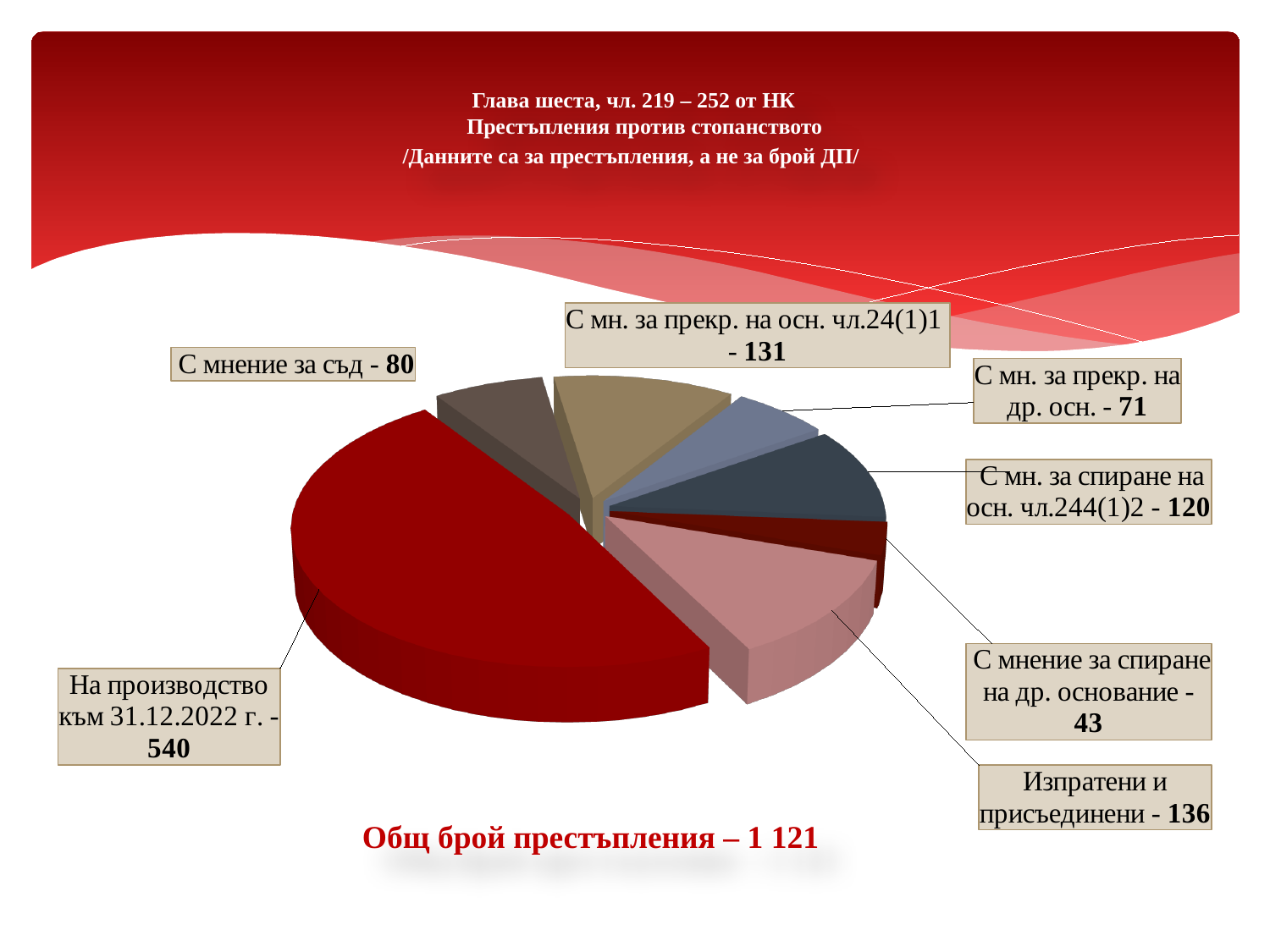
What is the total number of crimes stated on the slide (Общ брой престъпления)? 1 121 What is the difference between "С мн. за спиране на осн. чл.244(1)2" (120) and "С мнение за спиране на др. основание" (43)? 77 What is the value for "Изпратени и присъединени"? 136 Which category has the largest slice of the pie? На производство към 31.12.2022 г. What type of chart is shown on the slide? Pie chart What is the value for "На производство към 31.12.2022 г."? 540 What is the value for "С мнение за съд"? 80 What is the value for "С мн. за прекр. на др. осн."? 71 How many slices does the pie chart have? 7 Which is larger: "С мн. за прекр. на осн. чл.24(1)1" or "С мн. за спиране на осн. чл.244(1)2"? С мн. за прекр. на осн. чл.24(1)1 Which category has the smallest slice of the pie? С мнение за спиране на др. основание What is the difference between "На производство към 31.12.2022 г." (540) and "Изпратени и присъединени" (136)? 404